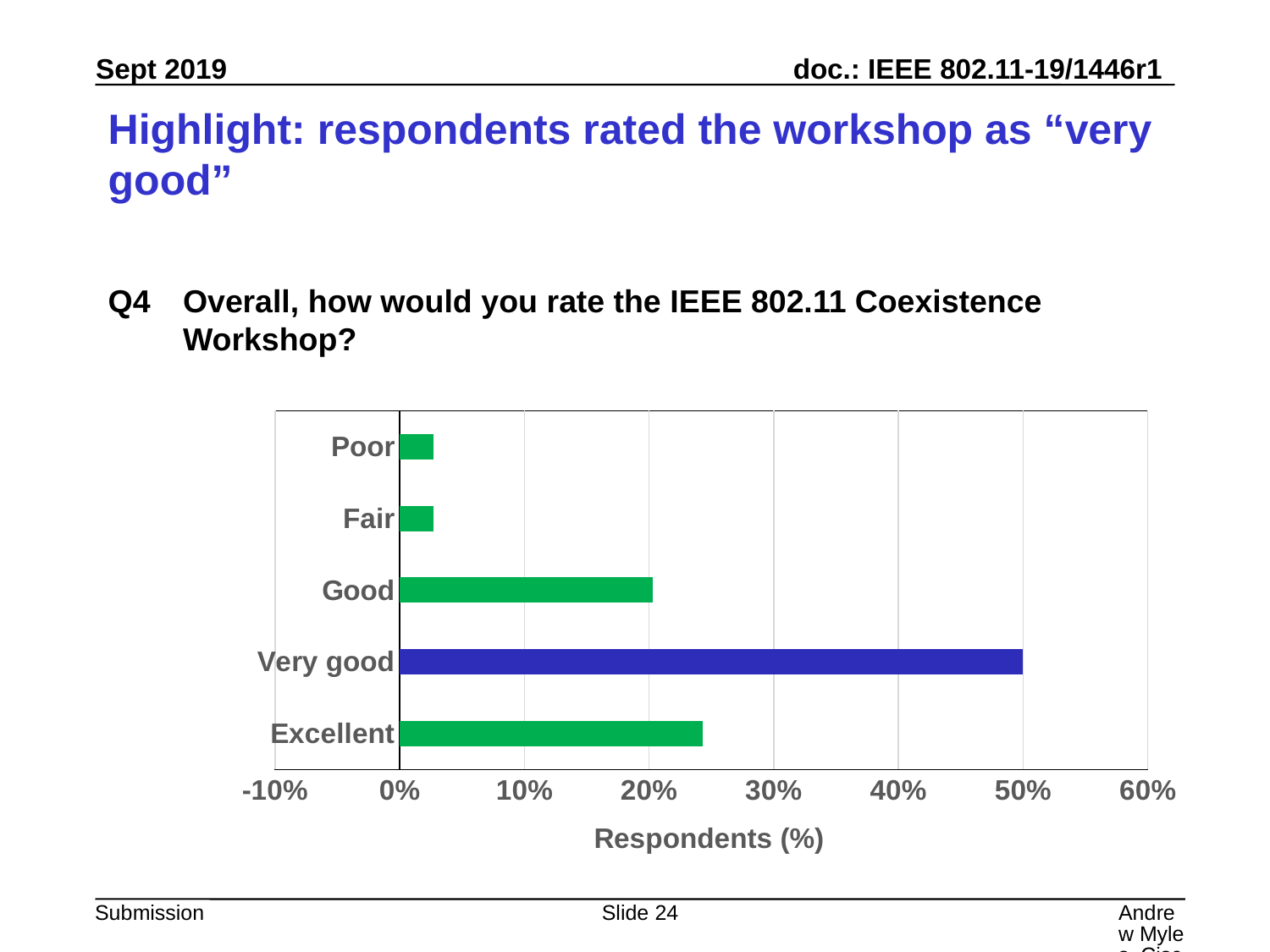
What percentage of respondents rated the workshop as "Very good"? 50% What is the title of the horizontal axis of the chart? Respondents (%) Which has a larger share of respondents, "Very good" or "Excellent"? Very good Is the value for "Excellent" greater or less than 20%? greater Which bar in the chart is coloured blue rather than green? Very good Is the value for "Poor" greater or less than 10%? less What kind of chart is shown on the slide? bar chart Which has a larger share of respondents, "Excellent" or "Good"? Excellent Which rating category has the highest percentage of respondents? Very good How many rating categories are shown on the chart? 5 Is the value for "Very good" greater or less than 40%? greater